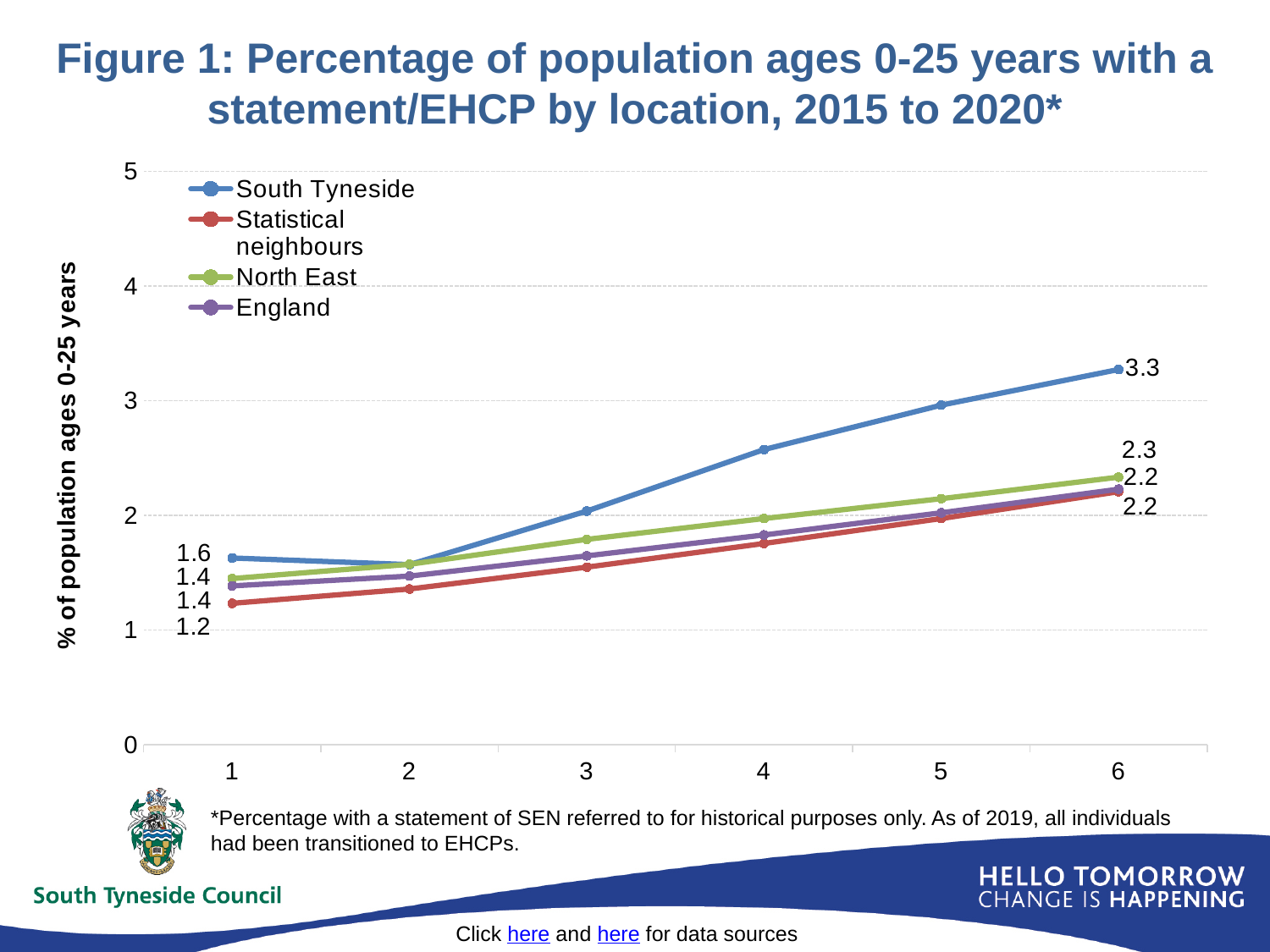
Which series has the highest value at point 6? South Tyneside How many series does the legend list? 4 What is the value for South Tyneside at point 6? 3.3 What is the difference between South Tyneside and North East at point 6? 1.0 What is the value for North East at point 6? 2.3 What is the value for Statistical neighbours at point 1? 1.2 Is the value for South Tyneside at point 4 greater or less than 2? greater Which series has the lowest value at point 1? Statistical neighbours What kind of chart is shown in Figure 1? line chart By how much did the South Tyneside value increase from point 1 to point 6? 1.7 What is the value for South Tyneside at point 1? 1.6 Does the South Tyneside line rise or fall from point 1 to point 6? rise